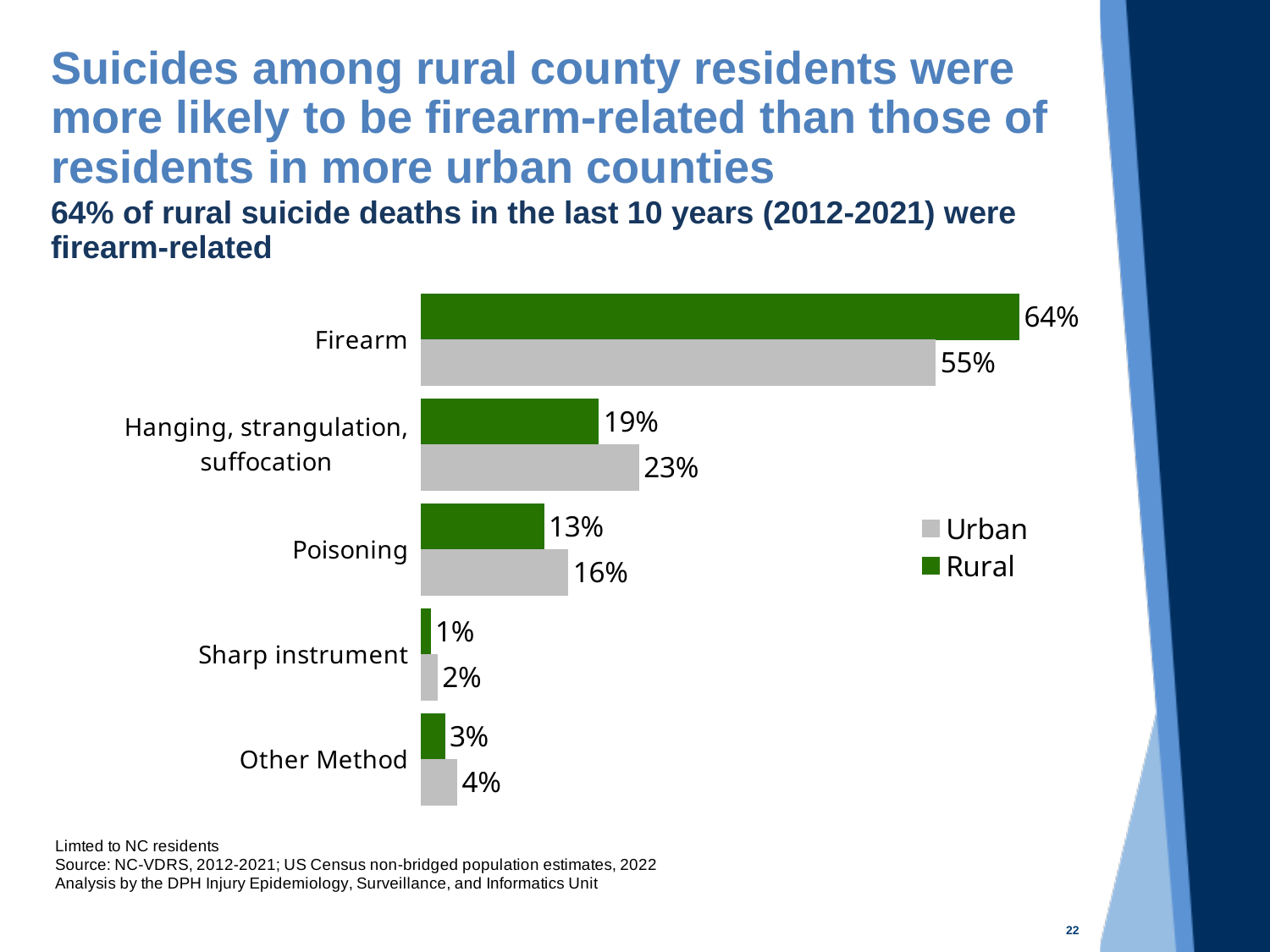
What is the Rural value for Sharp instrument? 1% What kind of chart is shown on the slide? Bar chart What is the difference between the Urban and Rural values for Poisoning? 3% What is the Urban value for Poisoning? 16% Which is larger for Hanging, strangulation, suffocation: the Urban value or the Rural value? Urban Which category has the lowest Rural value? Sharp instrument Which category has the highest Urban value? Firearm How many categories are shown on the chart? 5 What is the difference between the Rural and Urban values for Firearm? 9% What is the Rural value for Firearm? 64% How many series does the legend list? 2 What is the Urban value for Hanging, strangulation, suffocation? 23%